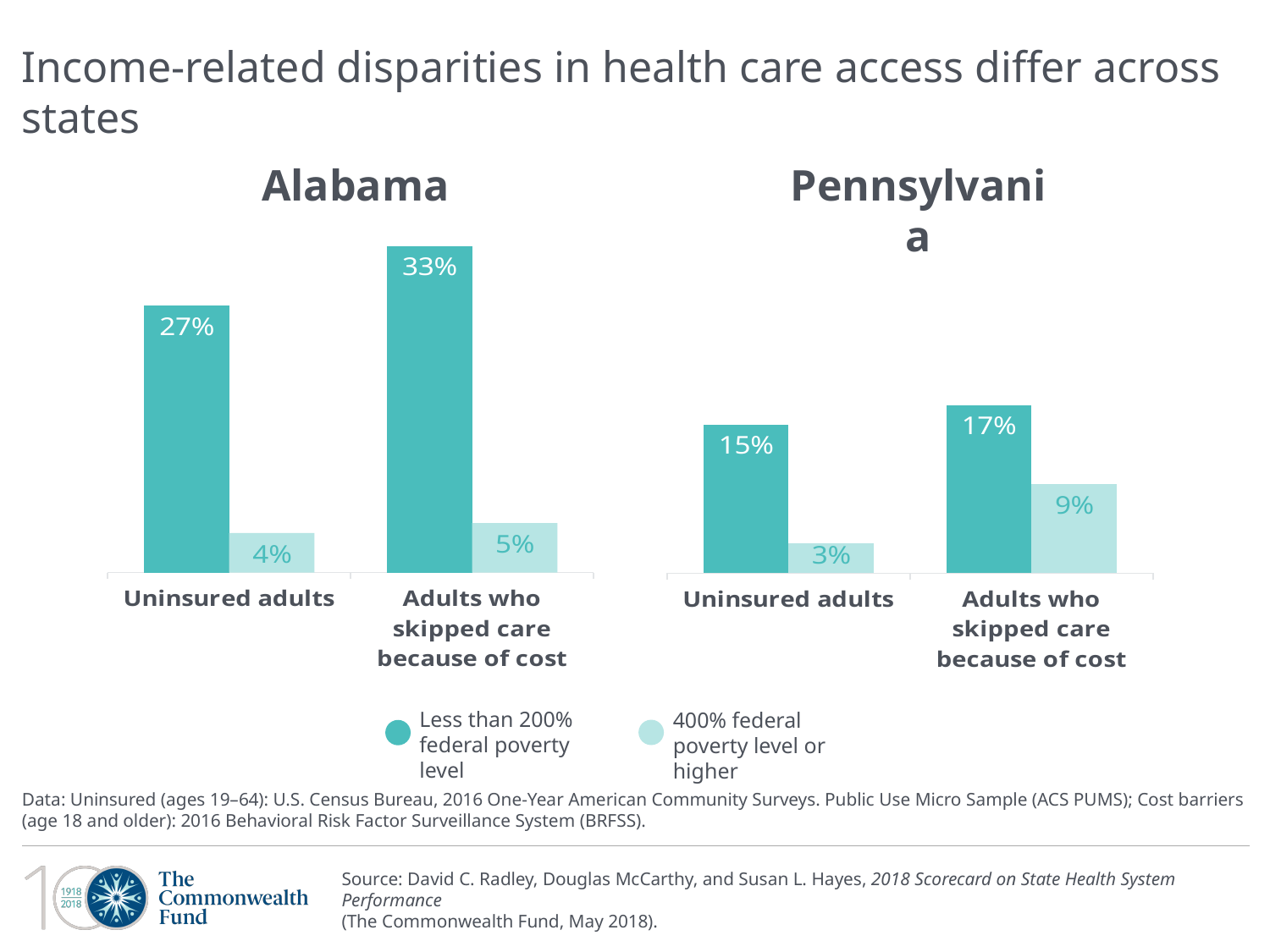
In the Pennsylvania chart, what is the value for uninsured adults with income less than 200% of the federal poverty level? 15% In the Pennsylvania chart, what is the value for adults who skipped care because of cost with income at 400% of the federal poverty level or higher? 9% In the Alabama chart, what is the value for adults who skipped care because of cost with income at 400% of the federal poverty level or higher? 5% In the Alabama chart, what is the difference between the two income groups for adults who skipped care because of cost? 28 percentage points Which is larger: the uninsured rate for adults below 200% of the federal poverty level in Alabama or in Pennsylvania? Alabama In the Alabama chart, which bar has the highest value? Adults who skipped care because of cost, less than 200% federal poverty level What type of chart is used for the Pennsylvania data? Bar chart In the Pennsylvania chart, which bar has the lowest value? Uninsured adults, 400% federal poverty level or higher In the Pennsylvania chart, what is the difference between the two income groups for uninsured adults? 12 percentage points In the Alabama chart, what is the value for uninsured adults with income less than 200% of the federal poverty level? 27% How many categories are shown on the x axis of the Alabama chart? 2 How many series does the legend list? 2